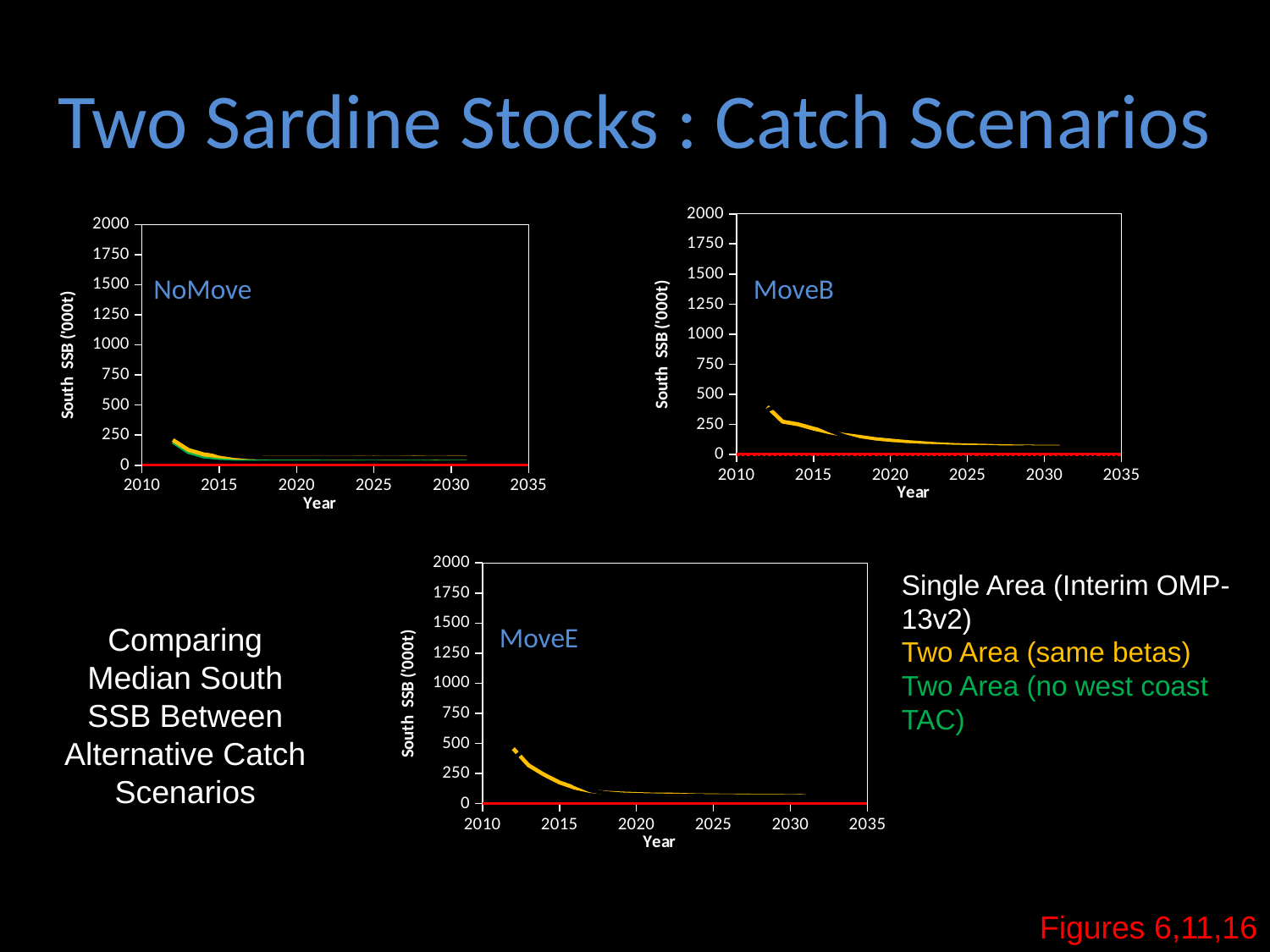
In the MoveB chart, does the yellow line rise or fall from 2012 to 2030? fall How many charts are shown on the slide? 3 In the MoveB chart, is the yellow line's value in 2030 greater or less than 250? less What kind of chart is the NoMove chart? line chart In the NoMove chart, does the yellow line rise or fall between 2012 and 2020? fall What is the y-axis label on the MoveE chart? South SSB ('000t) In the MoveE chart, does the yellow line rise or fall along the x axis? fall In the MoveB chart, is the yellow line's value in 2012 greater or less than 500? less What is the highest value shown on the y axis of the NoMove chart? 2000 In the NoMove chart, is the yellow line's value in 2012 greater or less than 500? less